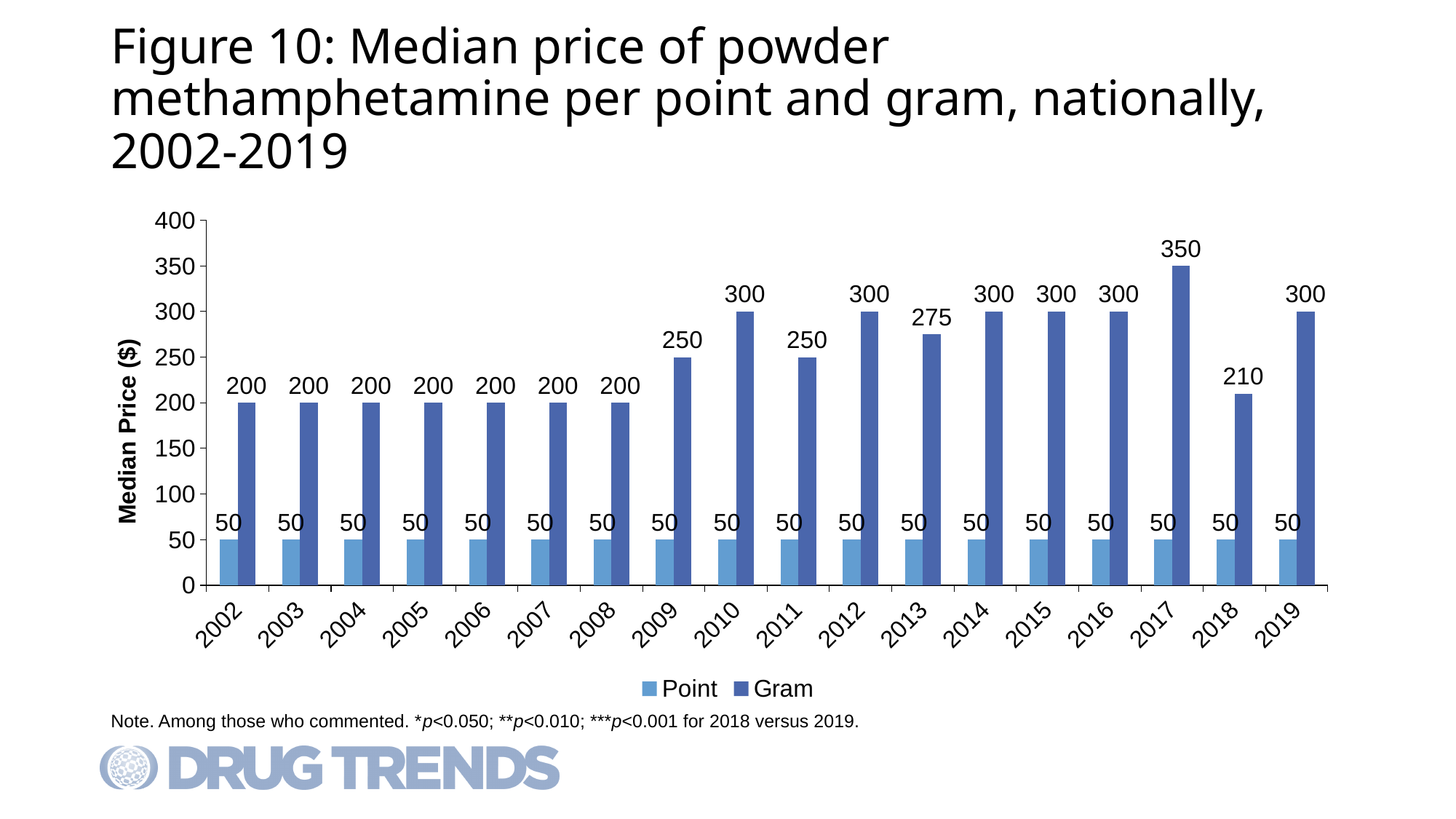
What is the label of the y axis? Median Price ($) What is the median price per gram in 2013? 275 What is the median price per gram in 2018? 210 What is the difference between the median price per gram in 2017 and in 2018? 140 In which year is the median price per gram highest? 2017 What is the median price per gram in 2017? 350 Which is larger, the median price per gram in 2009 or in 2010? 2010 What kind of chart is this? bar chart How many years are shown on the x axis? 18 What is the median price per point in 2010? 50 How many series does the legend list? 2 What is the difference between the median price per gram and per point in 2019? 250